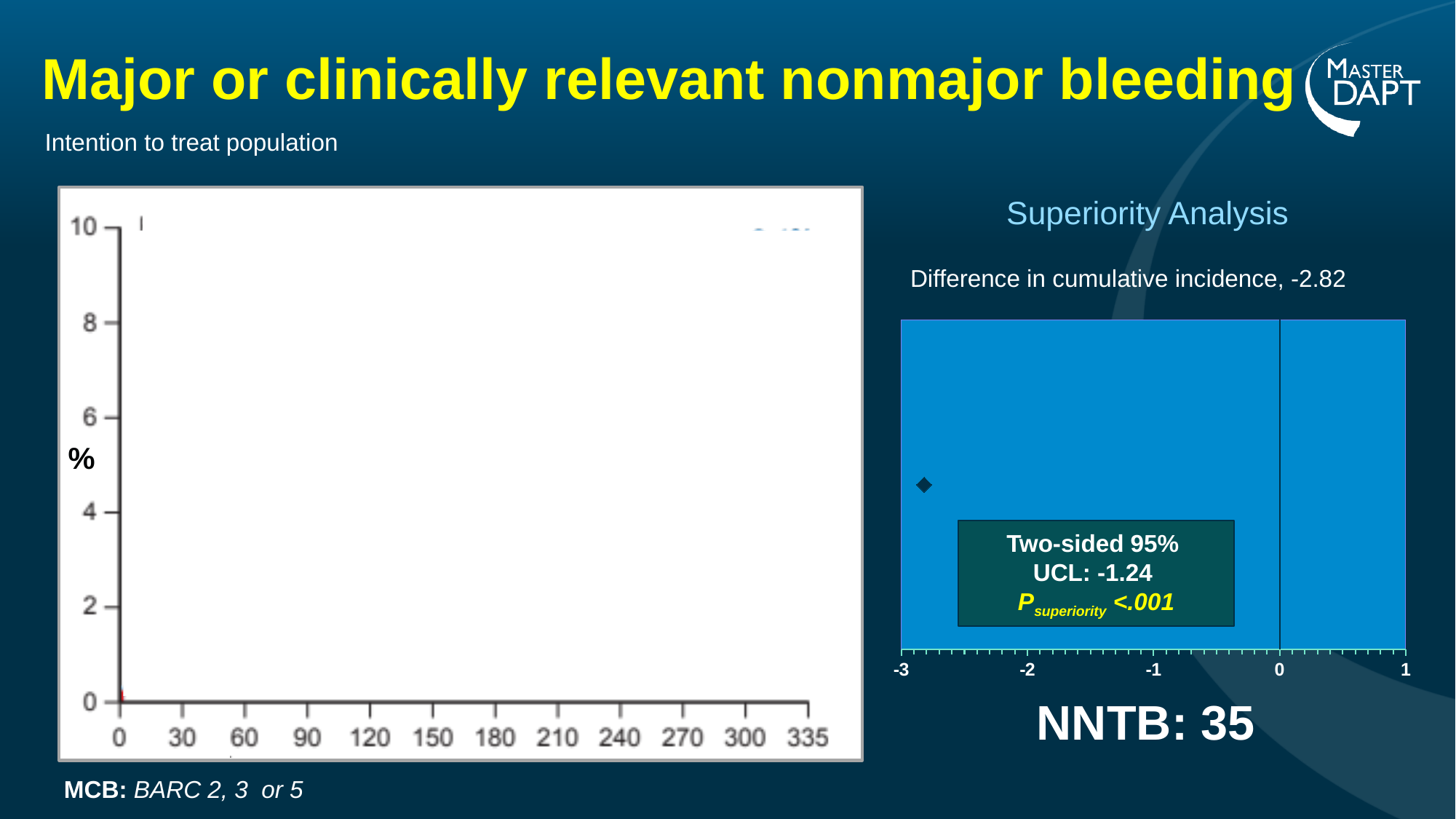
On the Superiority Analysis chart on the right, is the plotted point estimate greater or less than 0? less On the chart on the left, what is the last value labelled on the x axis? 335 On the Superiority Analysis chart on the right, is the plotted point estimate greater or less than -2? less On the Superiority Analysis chart on the right, what is the two-sided 95% UCL value? -1.24 On the chart on the left, what is the highest value labelled on the y axis? 10 On the Superiority Analysis chart on the right, what is the lowest value labelled on the x axis? -3 On the chart on the left, what unit label is shown on the y axis? % On the Superiority Analysis chart on the right, what P value for superiority is shown? <.001 What is the title of the chart on the right side of the slide? Superiority Analysis On the Superiority Analysis chart on the right, what NNTB value is shown below the axis? 35 On the Superiority Analysis chart on the right, what is the highest value labelled on the x axis? 1 On the Superiority Analysis chart on the right, what is the difference in cumulative incidence shown? -2.82